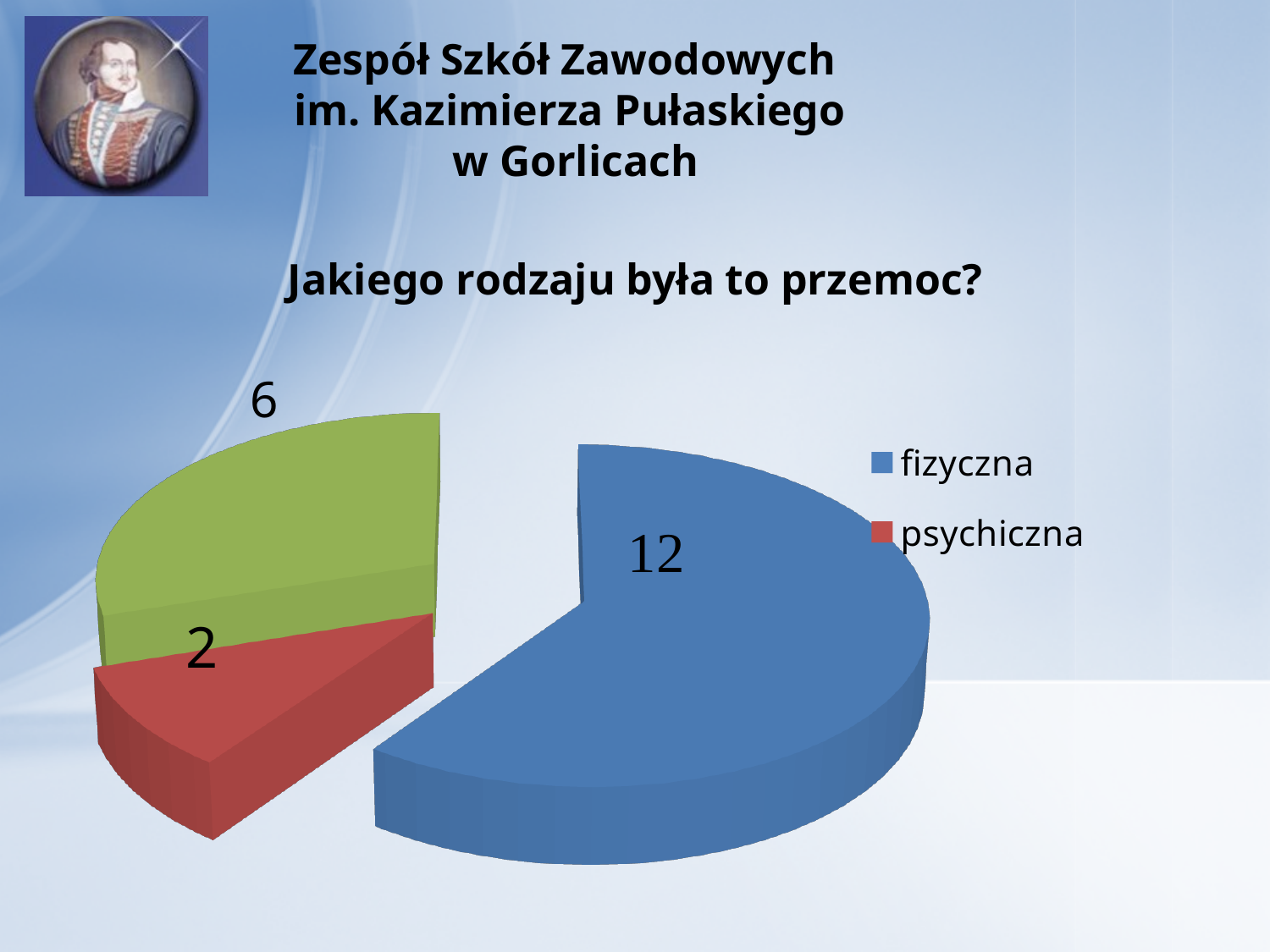
Which category has the smallest slice of the pie chart? psychiczna What kind of chart is shown on the slide? pie chart Which category has the largest slice of the pie chart? fizyczna Which is larger, the value for fizyczna or the value for psychiczna? fizyczna What share of the pie does the fizyczna slice represent? 60% What is the value for fizyczna in the pie chart? 12 What is the value for psychiczna in the pie chart? 2 What is the total of all the values shown in the pie chart? 20 What is the title of the chart on the slide? Jakiego rodzaju była to przemoc? What is the difference between the values for fizyczna and psychiczna? 10 How many slices does the pie chart have? 3 What share of the pie does the psychiczna slice represent? 10%